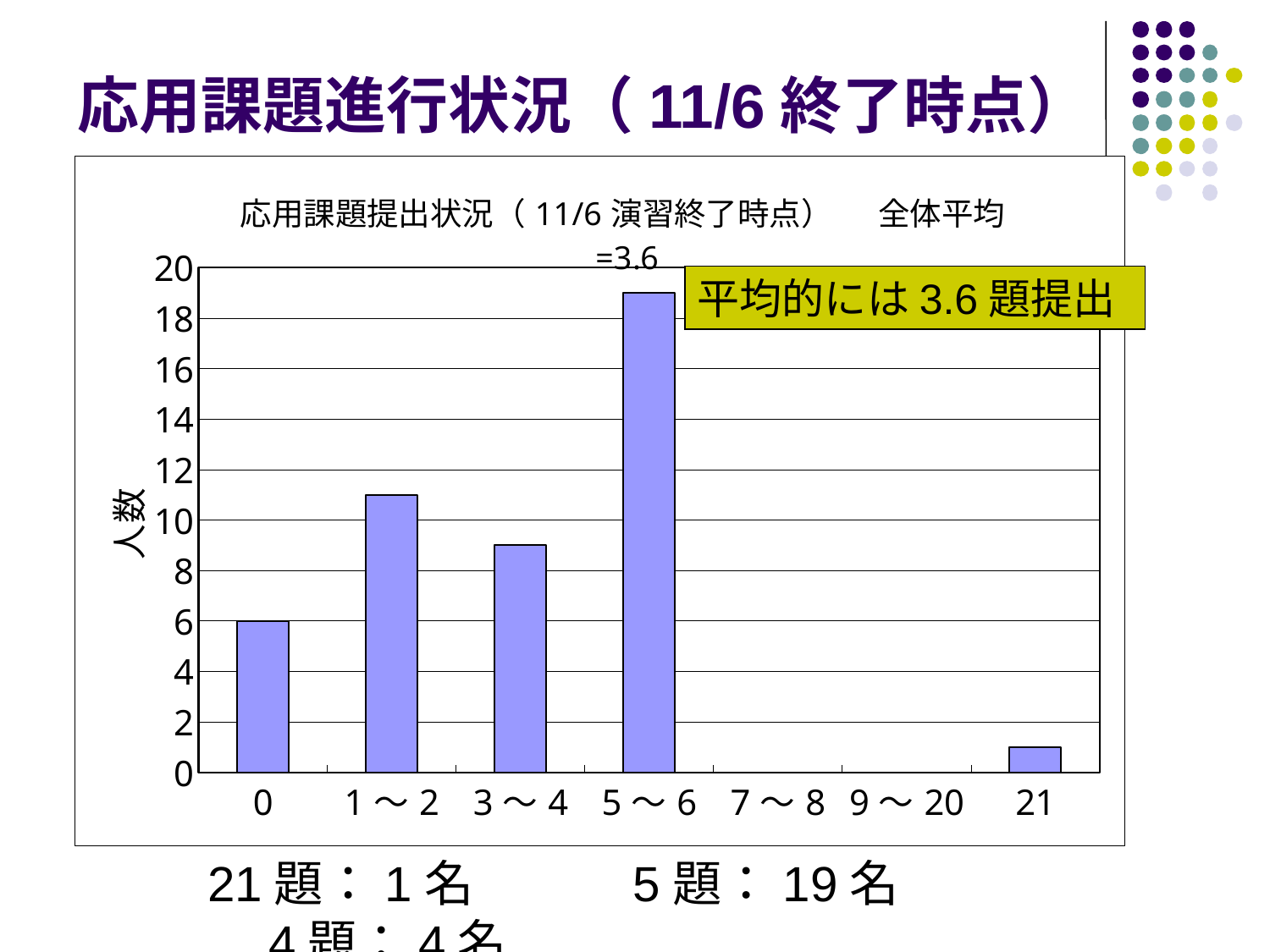
Is the value for the category 3～4 greater or less than 10? less Is the value for the category 1～2 greater or less than 10? greater What is the value (人数) for the category 0? 6 What overall average (全体平均) is stated in the chart title? 3.6 How many categories are shown on the x axis of the chart? 7 What is the value (人数) for the category 5～6? 19 What is the value (人数) for the category 21? 1 What kind of chart is shown on the slide? bar chart What is the label on the y axis of the chart? 人数 Which category has the highest bar in the chart? 5～6 What is the difference between the value for 5～6 and the value for 0? 13 Which category has a larger value, 1～2 or 3～4? 1～2